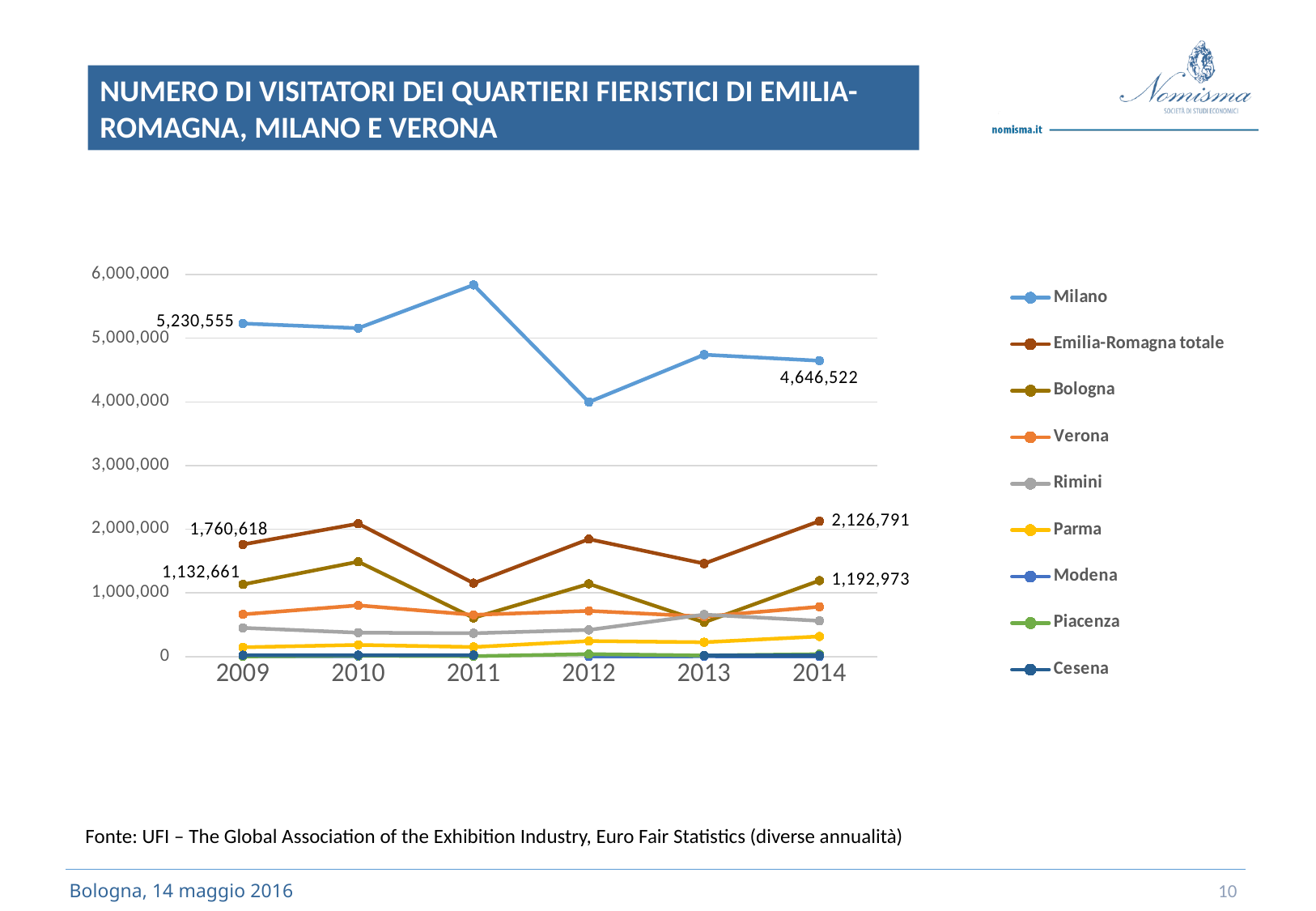
What is the value for Emilia-Romagna totale in 2014? 2,126,791 Is the value for Emilia-Romagna totale in 2011 greater or less than 2,000,000? less In which year does the Milano series reach its highest value? 2011 What kind of chart is shown on the slide? line chart What is the number of visitors for Milano in 2014? 4,646,522 By how much did the Milano value decrease from 2009 to 2014? 584,033 How many years are shown on the x axis? 6 Which series is plotted with the topmost line on the chart? Milano How many series does the legend list? 9 What is the number of visitors for Milano in 2009? 5,230,555 What is the value for Bologna in 2009? 1,132,661 What is the difference between the Emilia-Romagna totale values in 2014 and 2009? 366,173